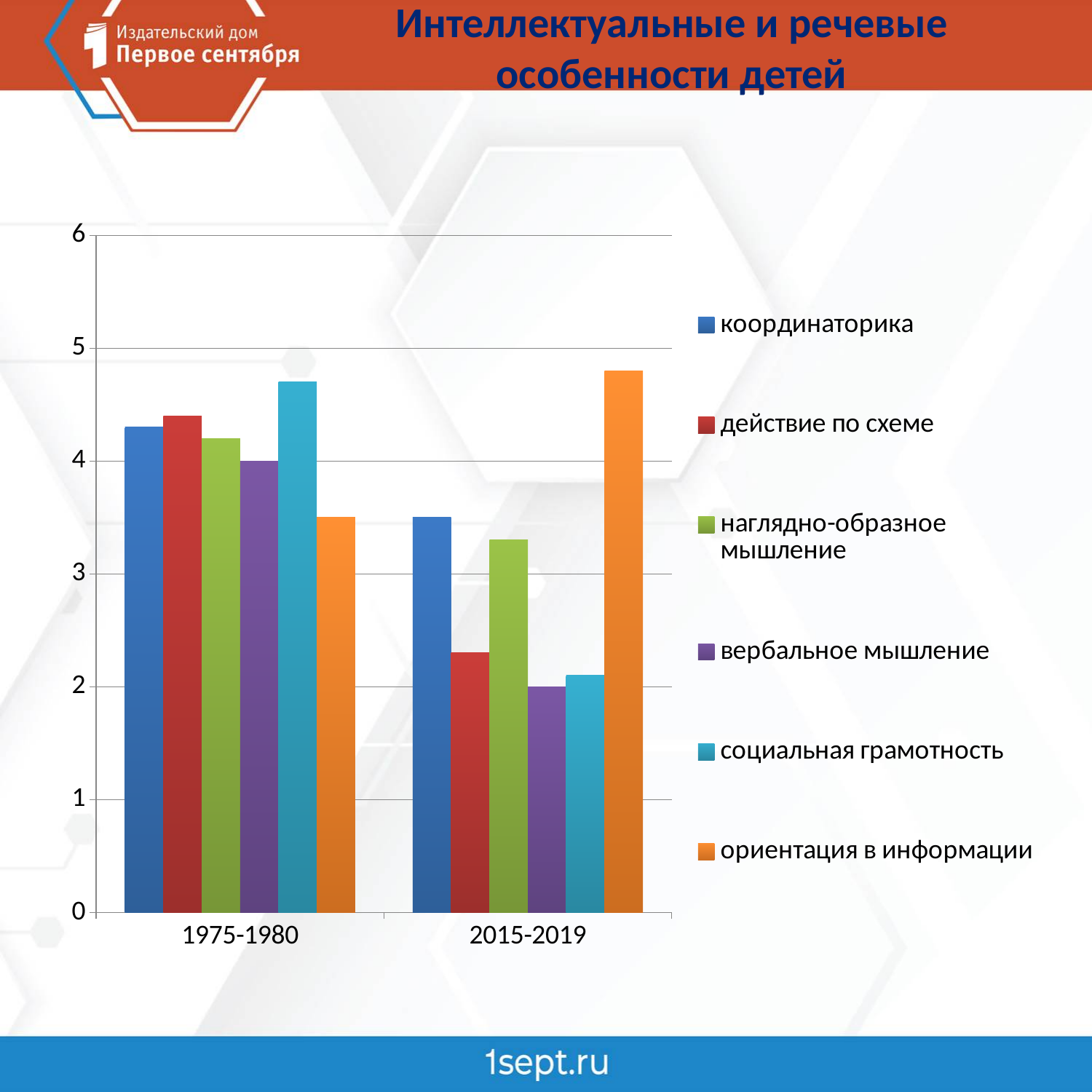
Is the value for действие по схеме in 2015-2019 greater or less than 3? less What kind of chart is shown on the slide? bar chart What is the value for вербальное мышление in 1975-1980? 4 Which series has the lowest value in 1975-1980? ориентация в информации Is the value for социальная грамотность in 1975-1980 greater or less than 4? greater How many categories are shown on the x axis? 2 What is the value for вербальное мышление in 2015-2019? 2 What is the difference between the values for вербальное мышление in 1975-1980 and 2015-2019? 2 Which series has the highest value in 2015-2019? ориентация в информации How many series does the legend list? 6 Which is larger: ориентация в информации in 1975-1980 or in 2015-2019? 2015-2019 Does the value for социальная грамотность rise or fall from 1975-1980 to 2015-2019? fall